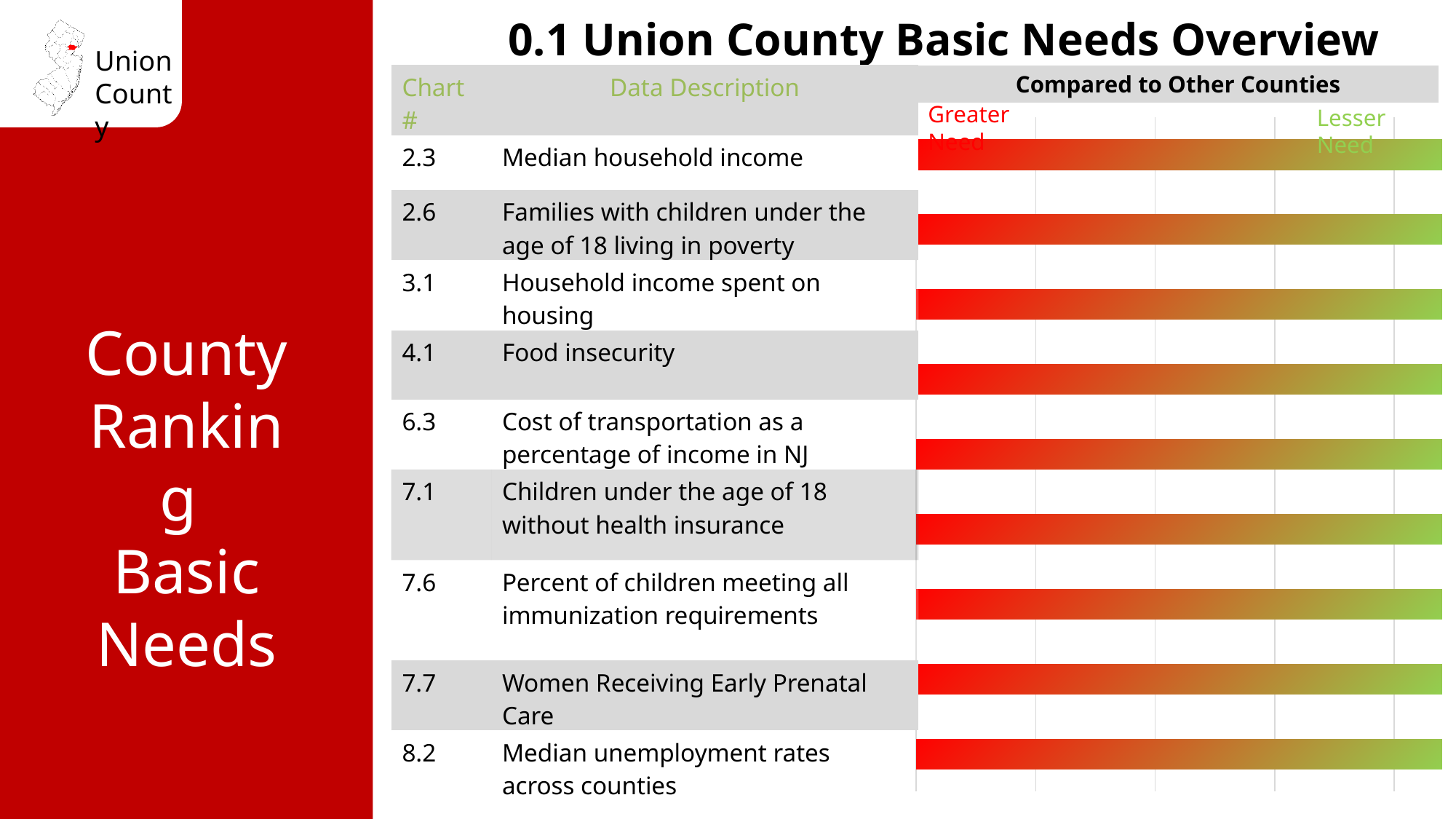
What kind of chart is used in the Compared to Other Counties section? bar chart What chart number is listed for Food insecurity? 4.1 What is the title of the slide containing the Compared to Other Counties chart? 0.1 Union County Basic Needs Overview What chart number is listed for Women Receiving Early Prenatal Care? 7.7 What label appears at the left (red) end of the bars in the Compared to Other Counties chart? Greater Need How many data descriptions (rows) have a bar plotted in the Compared to Other Counties chart? 9 What chart number is listed for Median household income? 2.3 Which data description is listed for chart number 8.2? Median unemployment rates across counties